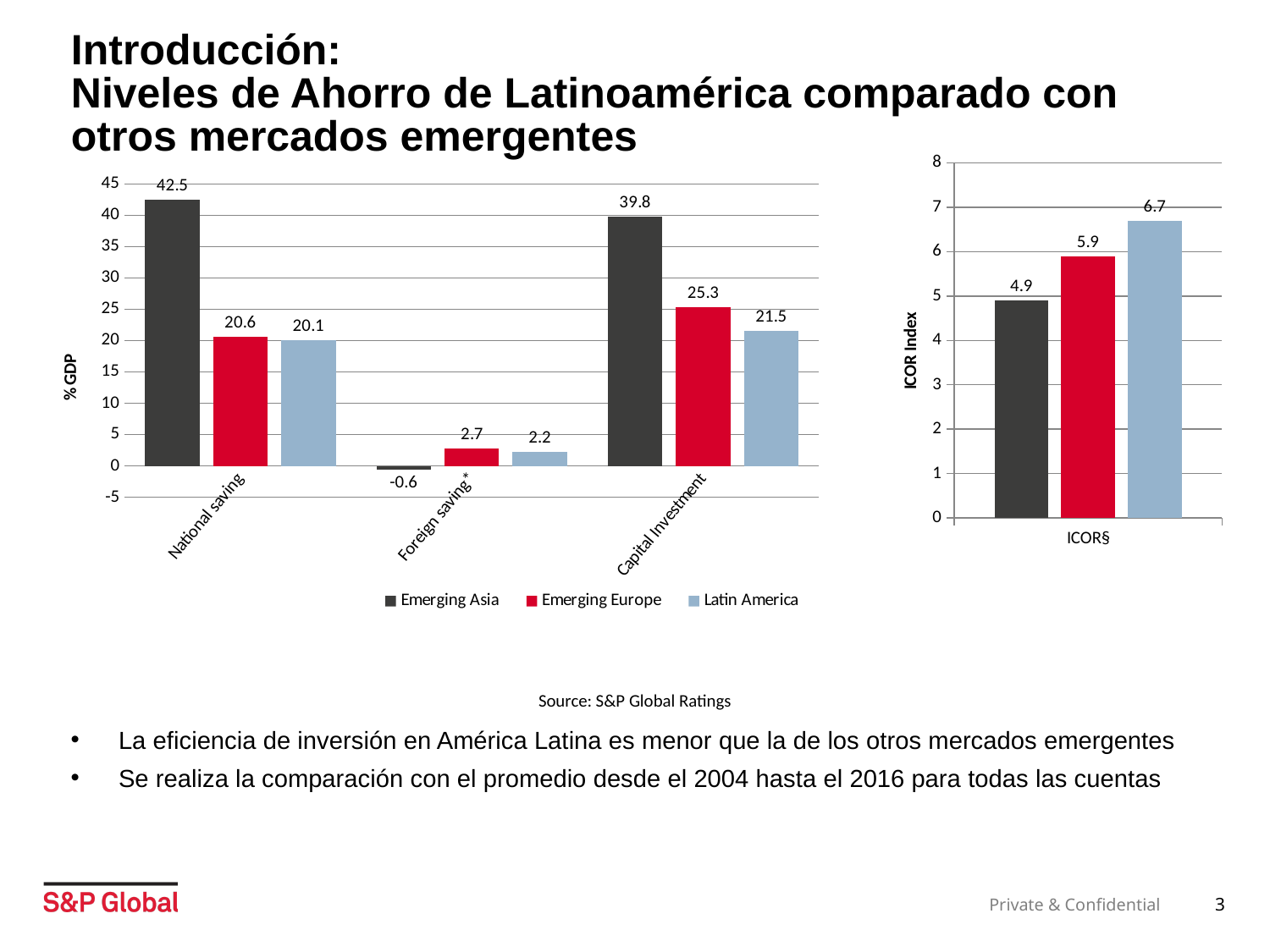
In the left chart (% GDP), what is the Foreign saving* value for Emerging Asia? -0.6 In the left chart (% GDP), what is the National saving value for Emerging Asia? 42.5 In the left chart (% GDP), which region has the lowest Foreign saving* value? Emerging Asia In the left chart (% GDP), what is the Capital Investment value for Emerging Europe? 25.3 In the left chart (% GDP), which is larger: Capital Investment for Emerging Europe or for Latin America? Emerging Europe In the right chart (ICOR Index), what is the difference between the highest and lowest bars? 1.8 How many categories are shown on the x axis of the left chart (% GDP)? 3 What kind of chart is the right chart (ICOR Index)? Bar chart How many series does the legend of the left chart (% GDP) list? 3 In the left chart (% GDP), what is the difference between the National saving values for Emerging Asia and Latin America? 22.4 In the left chart (% GDP), which region has the highest Capital Investment value? Emerging Asia In the right chart (ICOR Index), what is the value of the light blue bar (Latin America)? 6.7